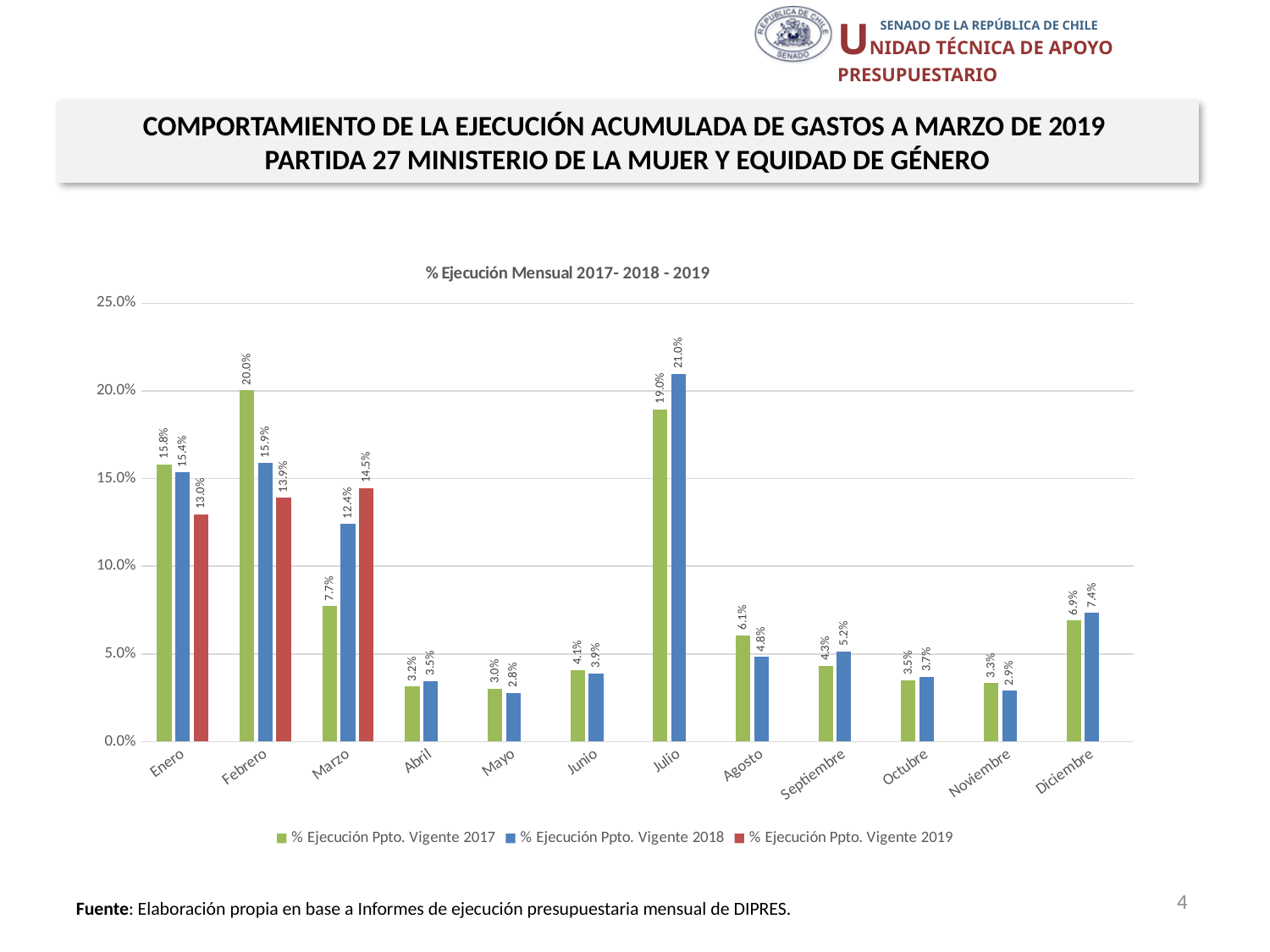
What is the difference between the 2017 and 2018 values in Marzo? 4.7% What kind of chart is shown on the slide? Bar chart Is the value for % Ejecución Ppto. Vigente 2017 in Julio greater or less than 15.0%? greater How many months are shown on the x axis? 12 Which month has the lowest value for % Ejecución Ppto. Vigente 2017? Mayo What is the title of the chart? % Ejecución Mensual 2017- 2018 - 2019 How many series does the legend list? 3 What is the value for % Ejecución Ppto. Vigente 2019 in Marzo? 14.5% Which month has the highest value for % Ejecución Ppto. Vigente 2018? Julio What is the value for % Ejecución Ppto. Vigente 2017 in Febrero? 20.0% What is the value for % Ejecución Ppto. Vigente 2018 in Julio? 21.0% Which is larger in Enero: the 2017 value or the 2019 value? 2017 value